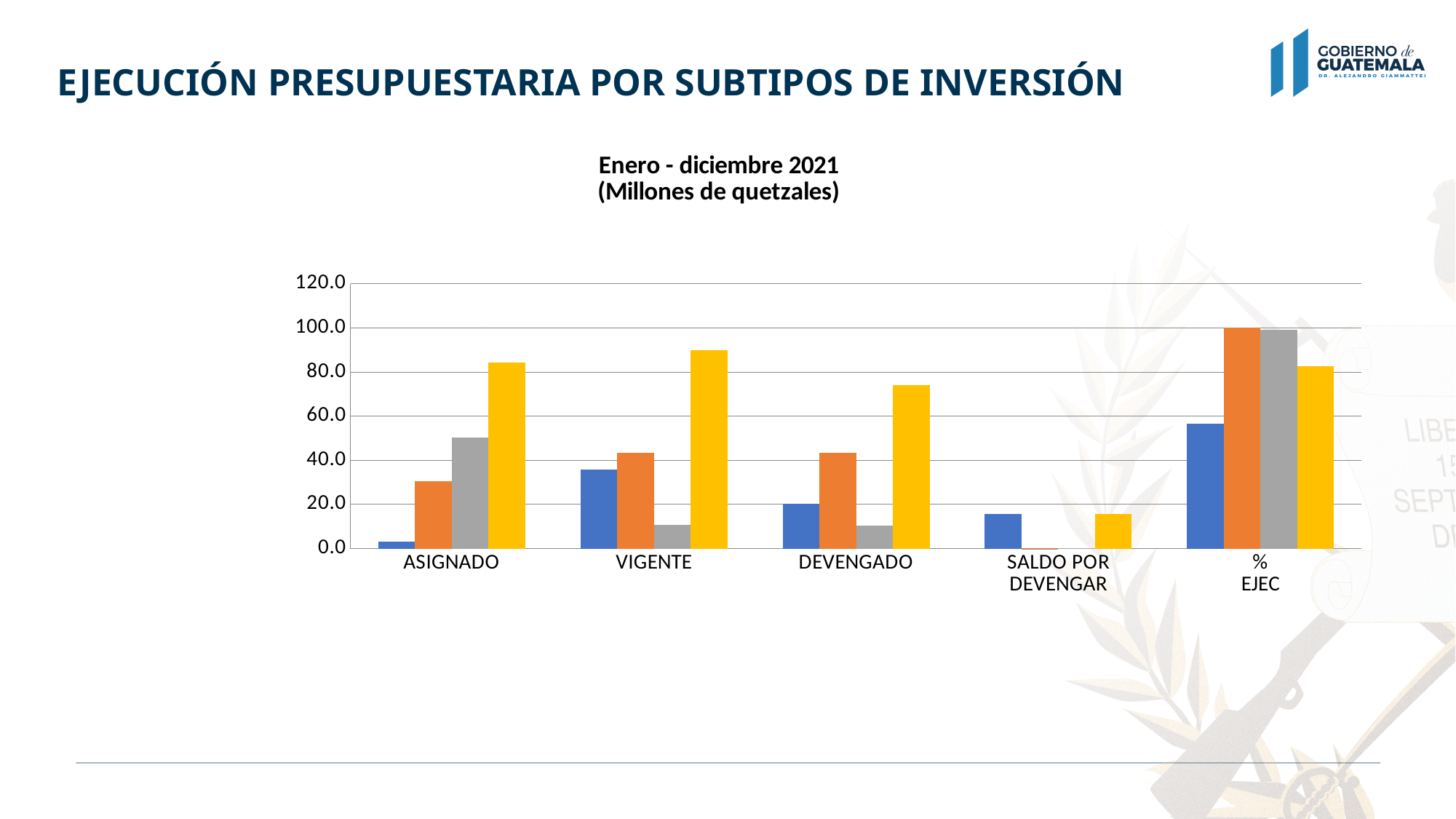
What is the subtitle printed above the chart? Enero - diciembre 2021 (Millones de quetzales) What kind of chart is shown on the slide? bar chart In which category is the blue bar the highest? % EJEC Is the blue bar for % EJEC greater or less than 40? greater How many categories are shown on the x axis of the chart? 5 Is the blue bar for VIGENTE greater or less than 40? less How many differently coloured bar series are plotted in each category? 4 Is the yellow bar for SALDO POR DEVENGAR greater or less than 20? less In the ASIGNADO category, which is larger, the yellow bar or the gray bar? the yellow bar In which category is the yellow bar the lowest? SALDO POR DEVENGAR In the % EJEC category, which is larger, the orange bar or the yellow bar? the orange bar